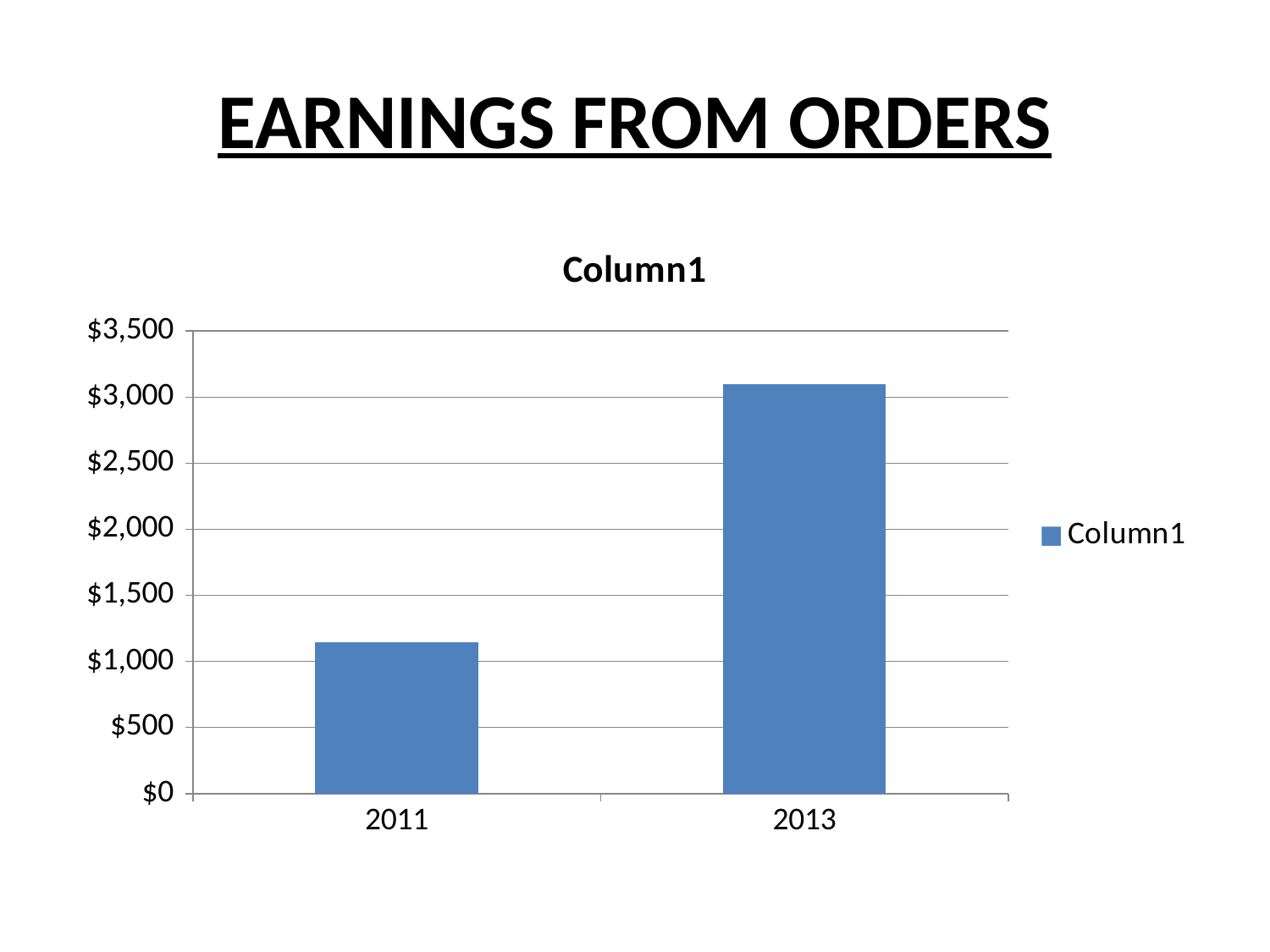
What kind of chart is shown on the slide? bar chart Is the value for 2013 greater or less than $3,000? greater Which is larger, the value for 2011 or the value for 2013? 2013 Which year has the lowest earnings from orders? 2011 Is the value for 2011 greater or less than $1,500? less What is the highest value shown on the vertical axis? $3,500 Which year has the highest earnings from orders? 2013 What is the title of the chart? Column1 How many series does the legend list? 1 Do the values rise or fall from 2011 to 2013? rise Is the value for 2011 greater or less than $1,000? greater How many bars are plotted in the chart? 2